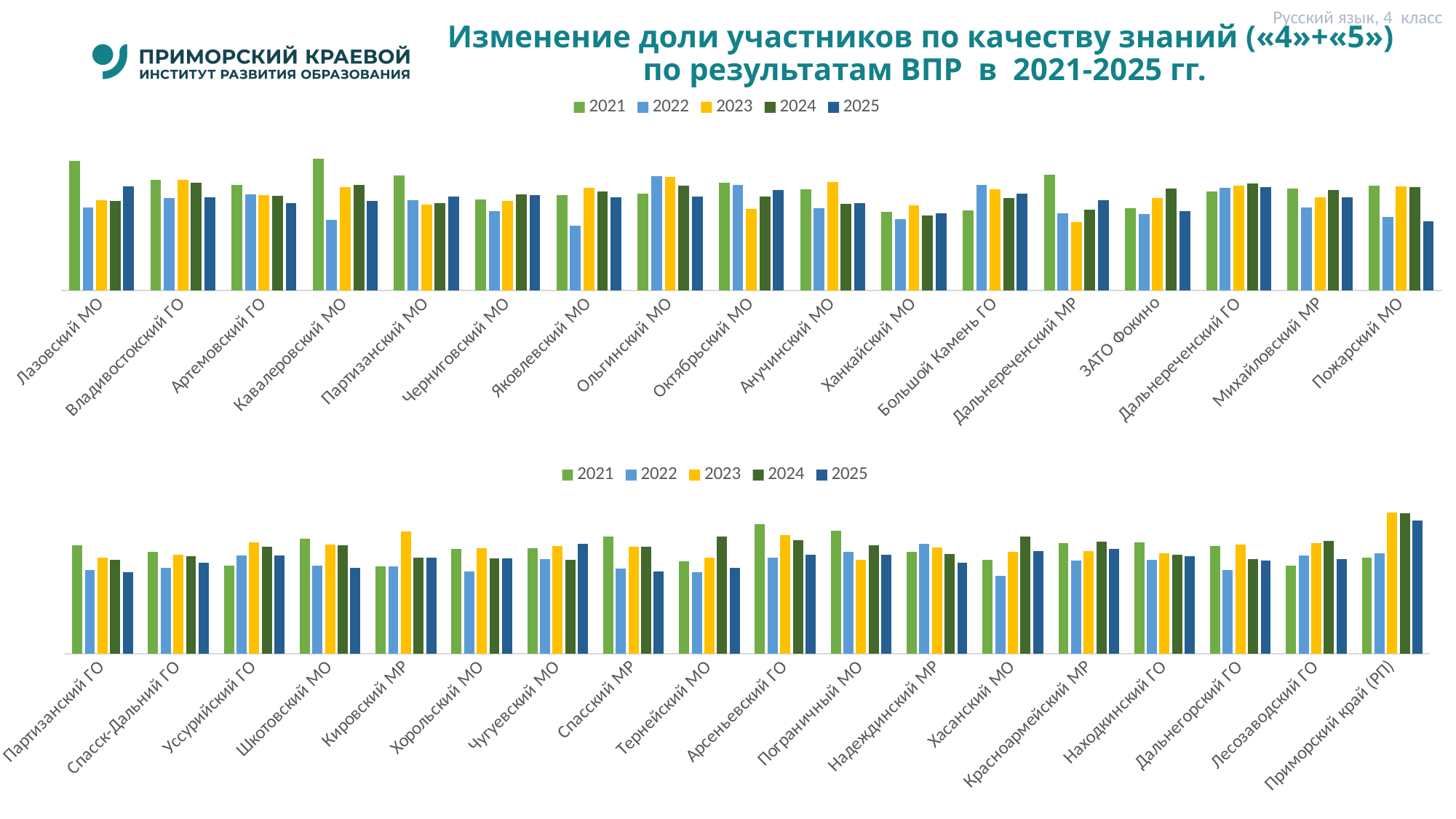
How many categories are shown on the x axis of the bottom chart? 18 Which colour represents the 2023 series in the legends of the charts? yellow How many series does the legend of the top chart list? 5 In the top chart, which year has the highest bar for Кавалеровский МО? 2021 In the top chart, for Ольгинский МО, which is larger: the 2021 value or the 2022 value? 2022 In the top chart, which year has the lowest bar for Кавалеровский МО? 2022 In the top chart, did the value for Лазовский МО rise or fall from 2021 to 2022? fall In the top chart, for Яковлевский МО, which is larger: the 2021 value or the 2022 value? 2021 In the bottom chart, for Арсеньевский ГО, which is larger: the 2021 value or the 2022 value? 2021 What kind of chart is the top chart on the slide? bar chart How many categories are shown on the x axis of the top chart? 17